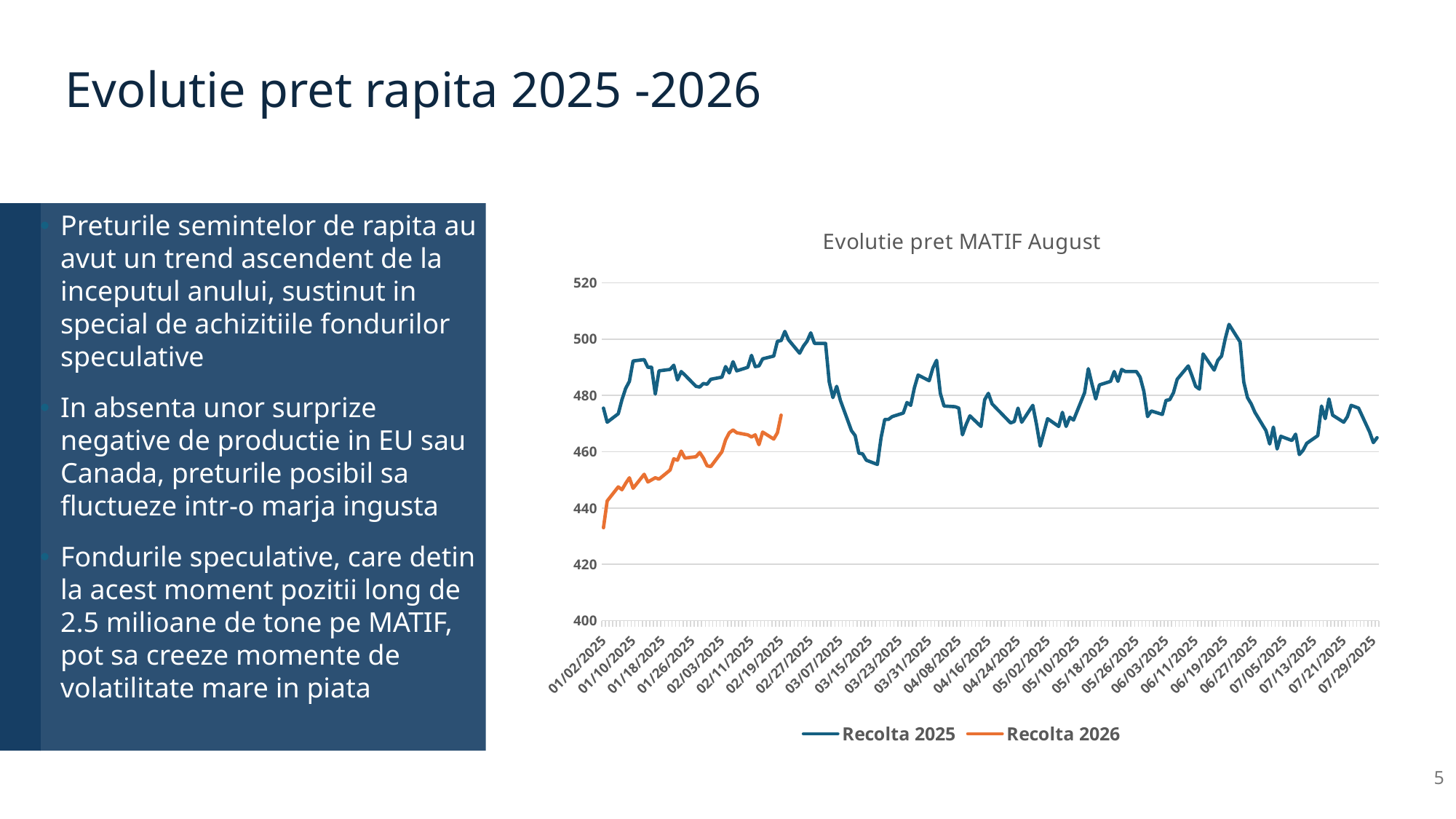
Is the peak value of Recolta 2025 around 06/19/2025 greater or less than 500? greater Does the Recolta 2026 line rise or fall overall from 01/02/2025 to its last point? rise Which series has the higher values during January and February 2025, Recolta 2025 or Recolta 2026? Recolta 2025 Is the first value of Recolta 2026 on 01/02/2025 greater or less than 440? less What is the title of the chart? Evolutie pret MATIF August How many series does the legend of the chart list? 2 Does the Recolta 2025 line rise or fall between 06/19/2025 and 07/05/2025? fall What kind of chart is shown on the slide? line chart Is the value of Recolta 2025 around 03/15/2025 greater or less than 480? less Which series is drawn in orange in the chart? Recolta 2026